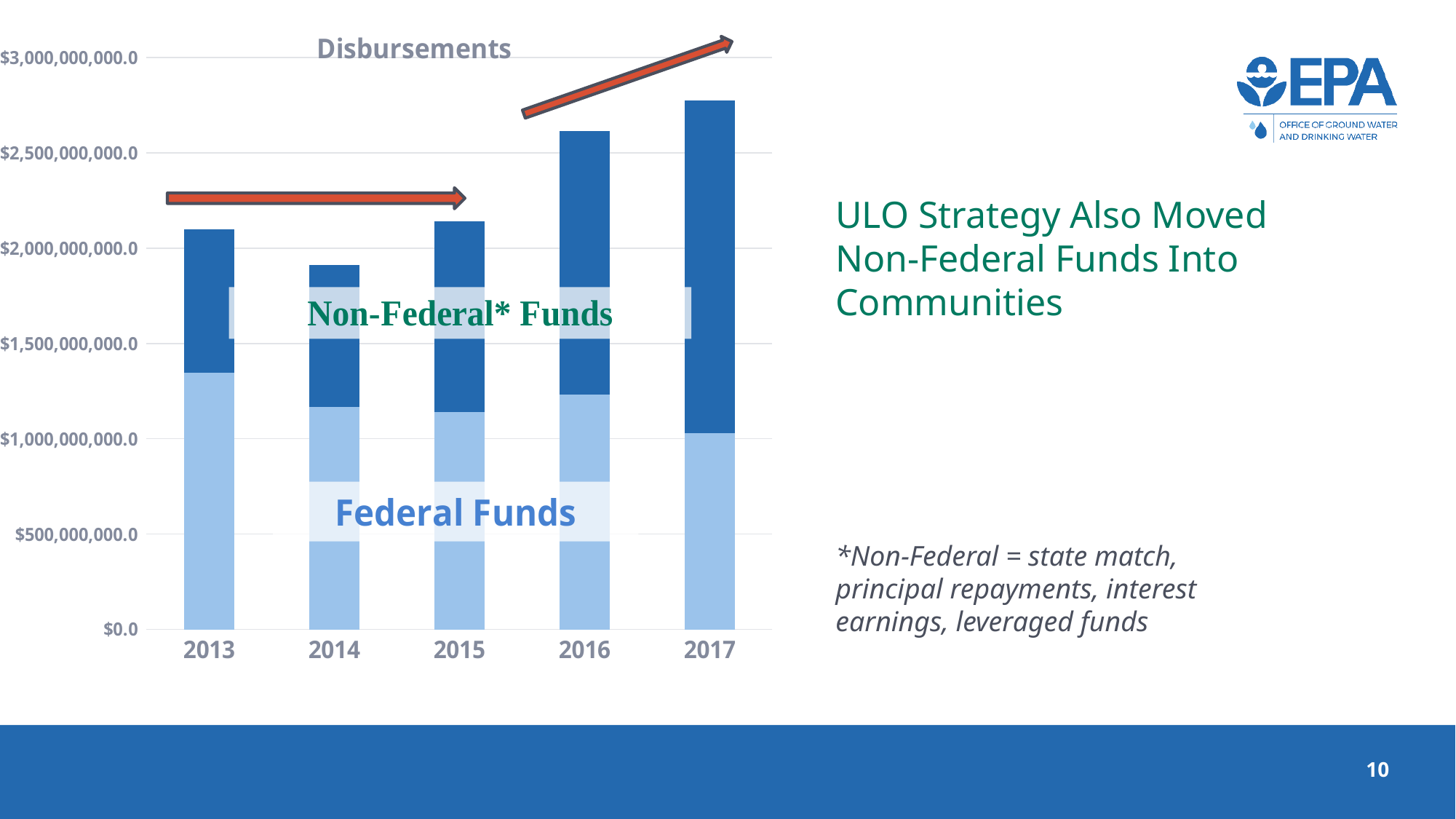
Which year has the shortest total bar in the chart? 2014 Is the total disbursement for 2017 greater or less than $2,500,000,000.0? greater Which year has the tallest total bar in the chart? 2017 How many years are shown on the x axis of the chart? 5 What is the title of the chart? Disbursements How many series are stacked in each bar of the chart? 2 Is the Federal Funds portion for 2013 greater or less than $1,000,000,000.0? greater Which year has a larger total disbursement, 2016 or 2014? 2016 What kind of chart is shown on the slide? Stacked bar chart Do the total disbursements rise or fall from 2015 to 2017? rise Which year has a larger Federal Funds portion, 2013 or 2017? 2013 Is the total disbursement for 2014 greater or less than $2,000,000,000.0? less